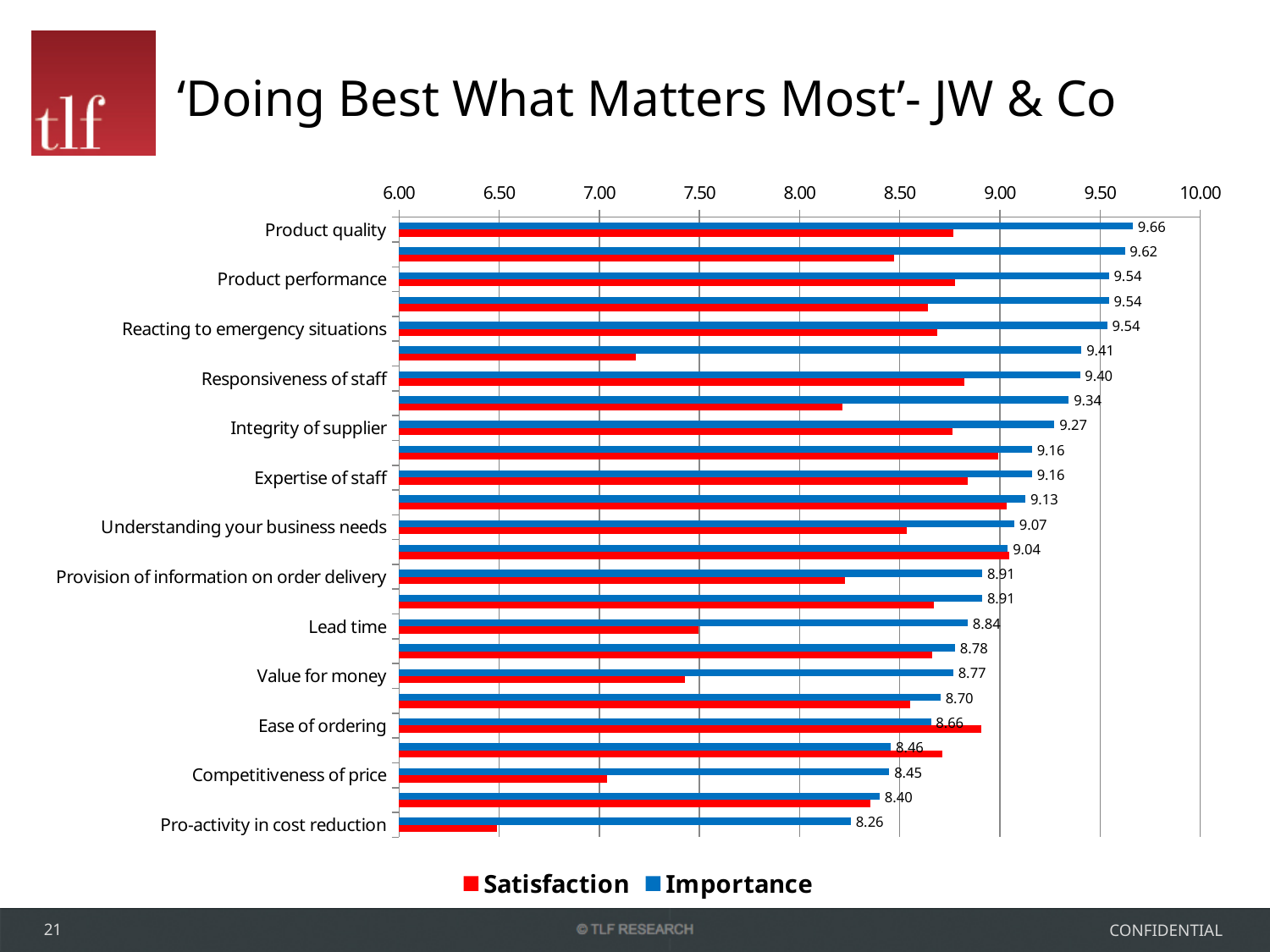
Which category has the lowest Importance value? Pro-activity in cost reduction What is the Importance value for Responsiveness of staff? 9.40 What is the Importance value for Lead time? 8.84 Which category has the highest Importance value? Product quality What is the Importance value for Pro-activity in cost reduction? 8.26 What is the Importance value for Product quality? 9.66 Is the Satisfaction value for Ease of ordering greater or less than 8.50? greater Which has a higher Importance value, Integrity of supplier or Value for money? Integrity of supplier What kind of chart is shown on the slide? Bar chart What is the difference between the Importance values for Product quality and Pro-activity in cost reduction? 1.40 Is the Satisfaction value for Pro-activity in cost reduction greater or less than 7.00? less How many series does the legend list? 2